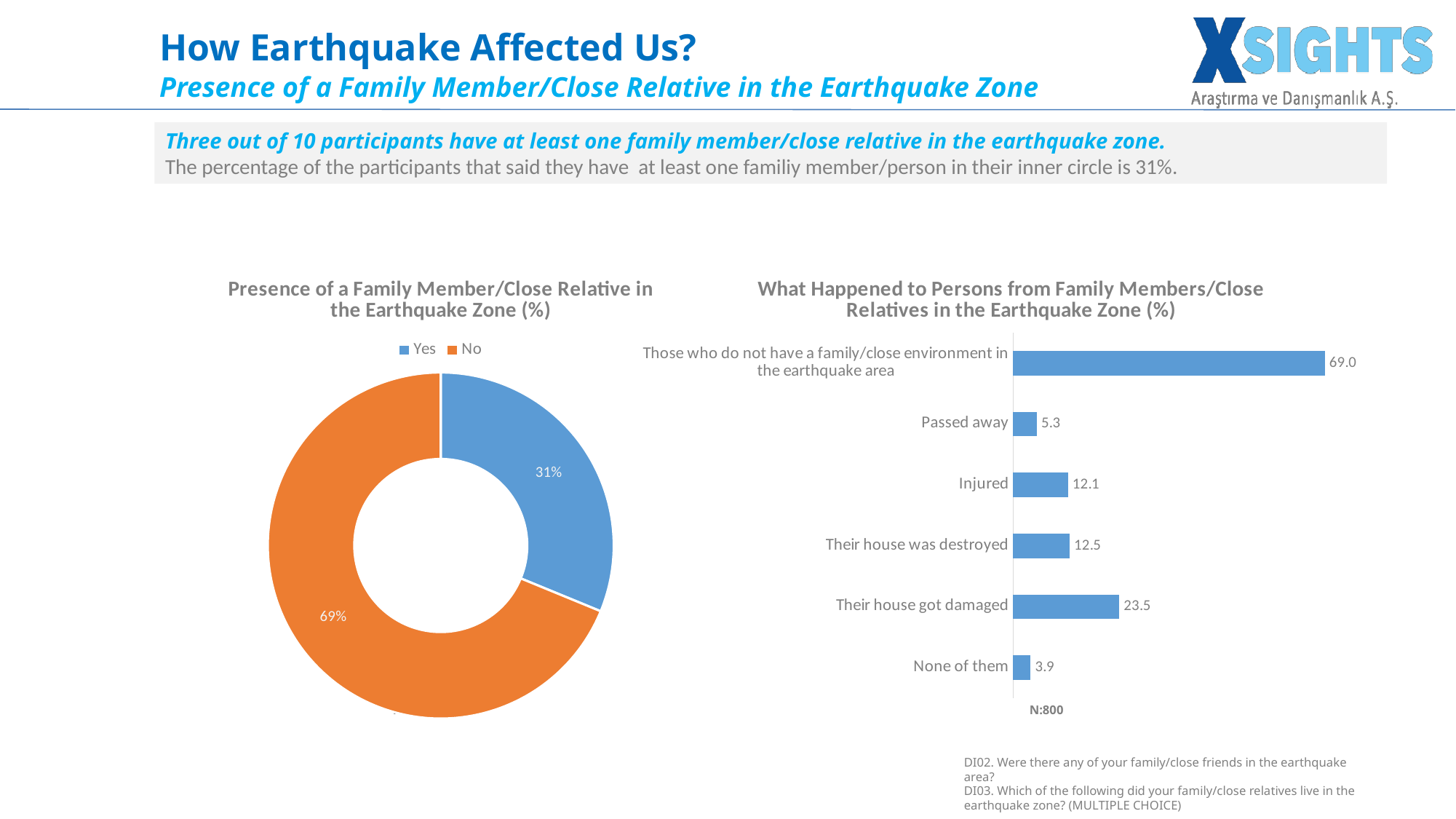
In the 'What Happened to Persons from Family Members/Close Relatives in the Earthquake Zone (%)' chart, what is the value for Their house got damaged? 23.5 How many entries does the legend of the 'Presence of a Family Member/Close Relative in the Earthquake Zone (%)' chart list? 2 In the 'What Happened to Persons from Family Members/Close Relatives in the Earthquake Zone (%)' chart, which category has the lowest value? None of them In the 'Presence of a Family Member/Close Relative in the Earthquake Zone (%)' chart, what percentage answered Yes? 31% In the 'Presence of a Family Member/Close Relative in the Earthquake Zone (%)' chart, what percentage answered No? 69% What kind of chart is the 'Presence of a Family Member/Close Relative in the Earthquake Zone (%)' chart? Pie chart (doughnut) In the 'Presence of a Family Member/Close Relative in the Earthquake Zone (%)' chart, which colour represents No? Orange In the 'What Happened to Persons from Family Members/Close Relatives in the Earthquake Zone (%)' chart, what is the difference between Their house got damaged and Injured? 11.4 In the 'What Happened to Persons from Family Members/Close Relatives in the Earthquake Zone (%)' chart, which is larger: Passed away or None of them? Passed away In the 'What Happened to Persons from Family Members/Close Relatives in the Earthquake Zone (%)' chart, what is the value for Passed away? 5.3 How many categories are shown in the 'What Happened to Persons from Family Members/Close Relatives in the Earthquake Zone (%)' chart? 6 In the 'What Happened to Persons from Family Members/Close Relatives in the Earthquake Zone (%)' chart, which category has the highest value? Those who do not have a family/close environment in the earthquake area